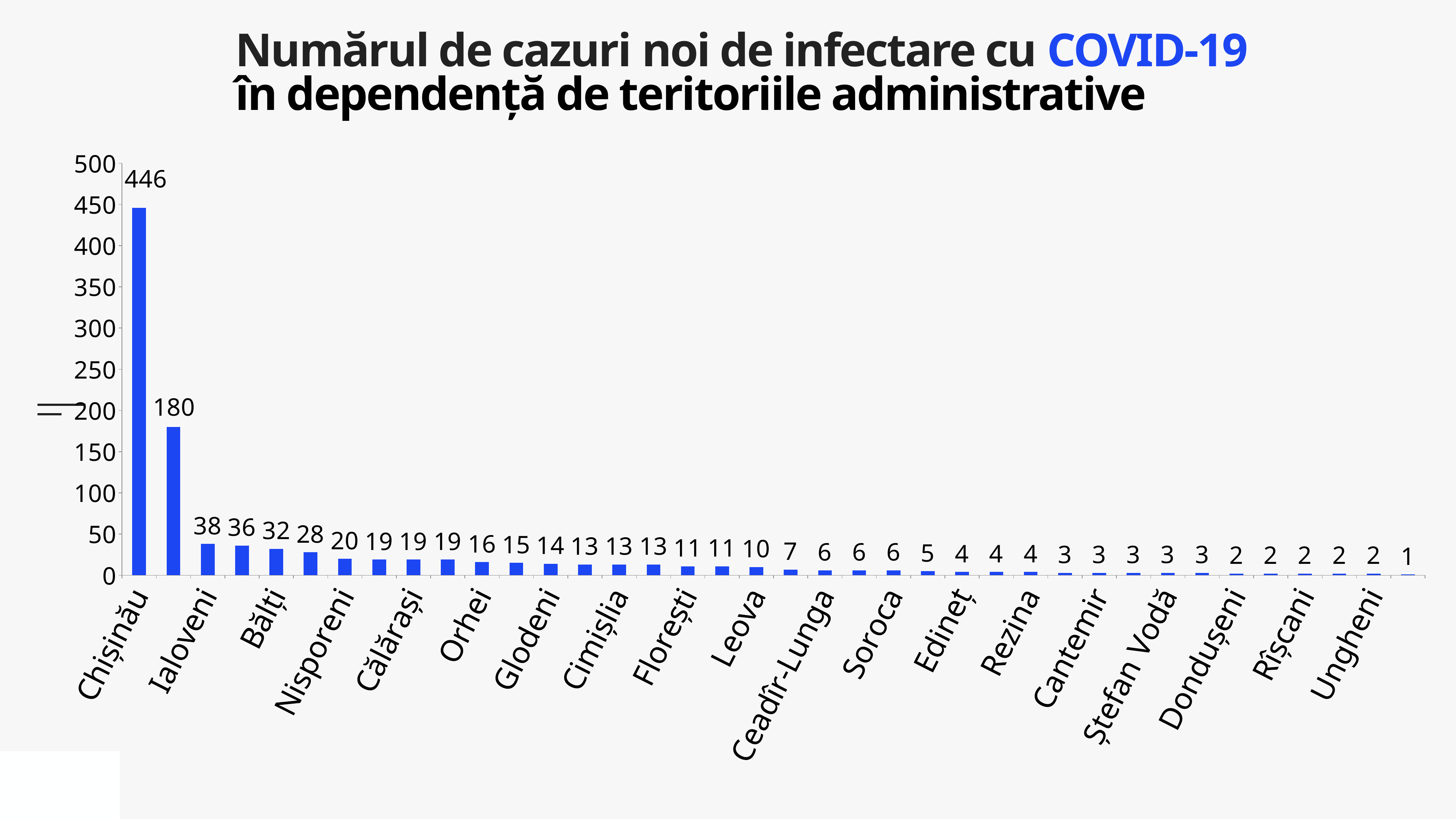
What type of chart is shown on the slide? bar chart What is the value of the second-highest bar in the chart? 180 How many bars are plotted in the chart? 38 How many new COVID-19 cases are shown for Chișinău? 446 What is the value of the lowest bar in the chart? 1 Is the value for Chișinău greater or less than 400? greater What is the difference between the highest bar (446) and the second-highest bar (180)? 266 Which territory has the highest number of new COVID-19 cases? Chișinău Do the values rise or fall from left to right along the x axis? fall Which is larger, the value for Chișinău or the second bar at 180? Chișinău What is the maximum value shown on the vertical axis? 500 What colour are the bars in the chart? blue